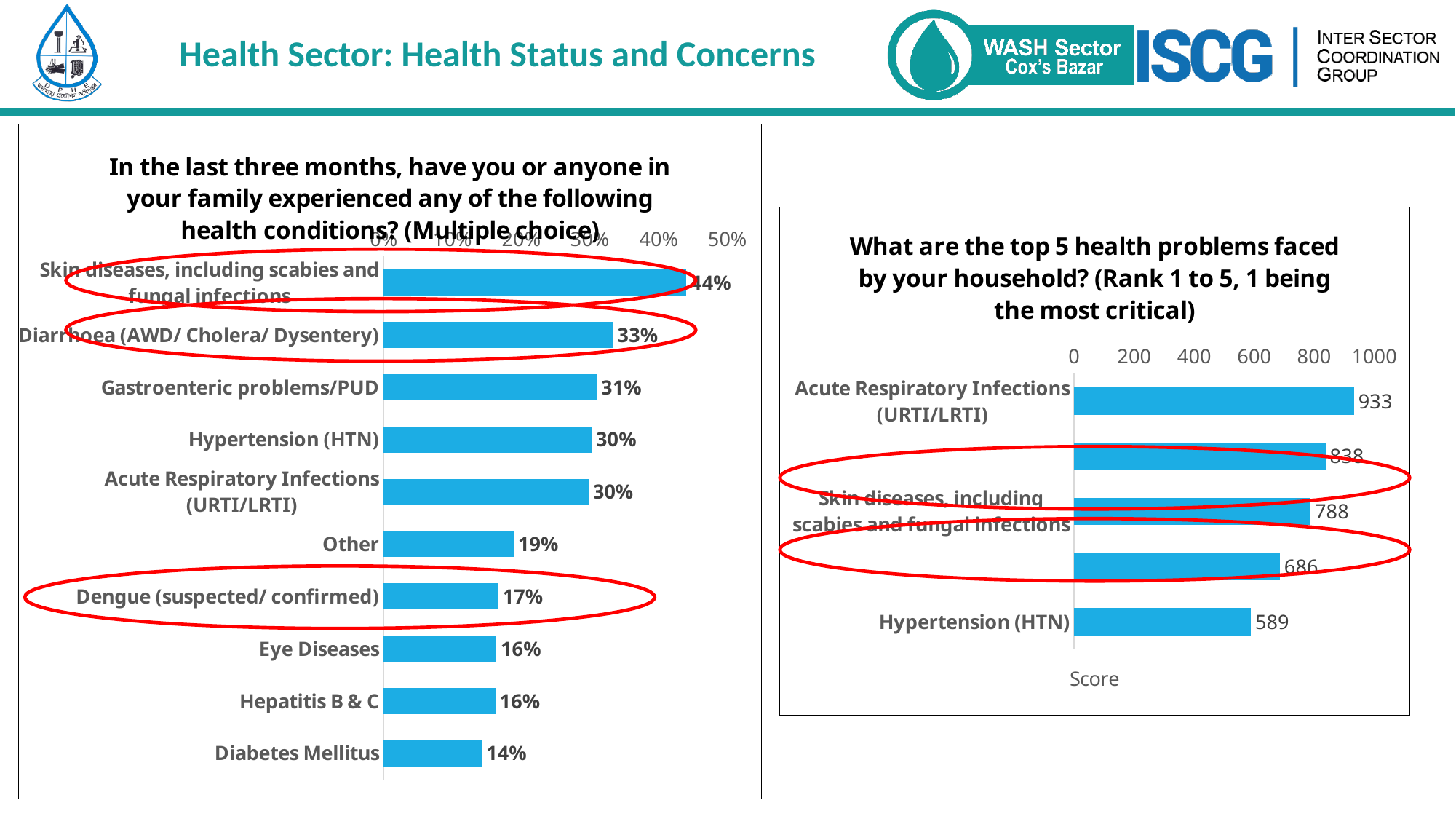
In the left chart (health conditions experienced in the last three months), how many health conditions are listed? 10 In the left chart (health conditions experienced in the last three months), what is the difference in percentage points between Skin diseases and Diarrhoea? 11 In the left chart (health conditions experienced in the last three months), what percentage is shown for Diarrhoea (AWD/ Cholera/ Dysentery)? 33% In the left chart (health conditions experienced in the last three months), what percentage is shown for Dengue (suspected/ confirmed)? 17% In the right chart (top 5 health problems faced by your household), what is the difference between the scores for Acute Respiratory Infections (URTI/LRTI) and Hypertension (HTN)? 344 In the left chart (health conditions experienced in the last three months), which health condition has the lowest percentage? Diabetes Mellitus In the right chart (top 5 health problems faced by your household), what is the score for Hypertension (HTN)? 589 In the right chart (top 5 health problems faced by your household), which health problem has the highest score? Acute Respiratory Infections (URTI/LRTI) In the right chart (top 5 health problems faced by your household), what is the score for Acute Respiratory Infections (URTI/LRTI)? 933 What type of chart is the left chart (health conditions experienced in the last three months)? Bar chart In the left chart (health conditions experienced in the last three months), what percentage is shown for Skin diseases, including scabies and fungal infections? 44% In the left chart (health conditions experienced in the last three months), which is larger: Gastroenteric problems/PUD or Other? Gastroenteric problems/PUD